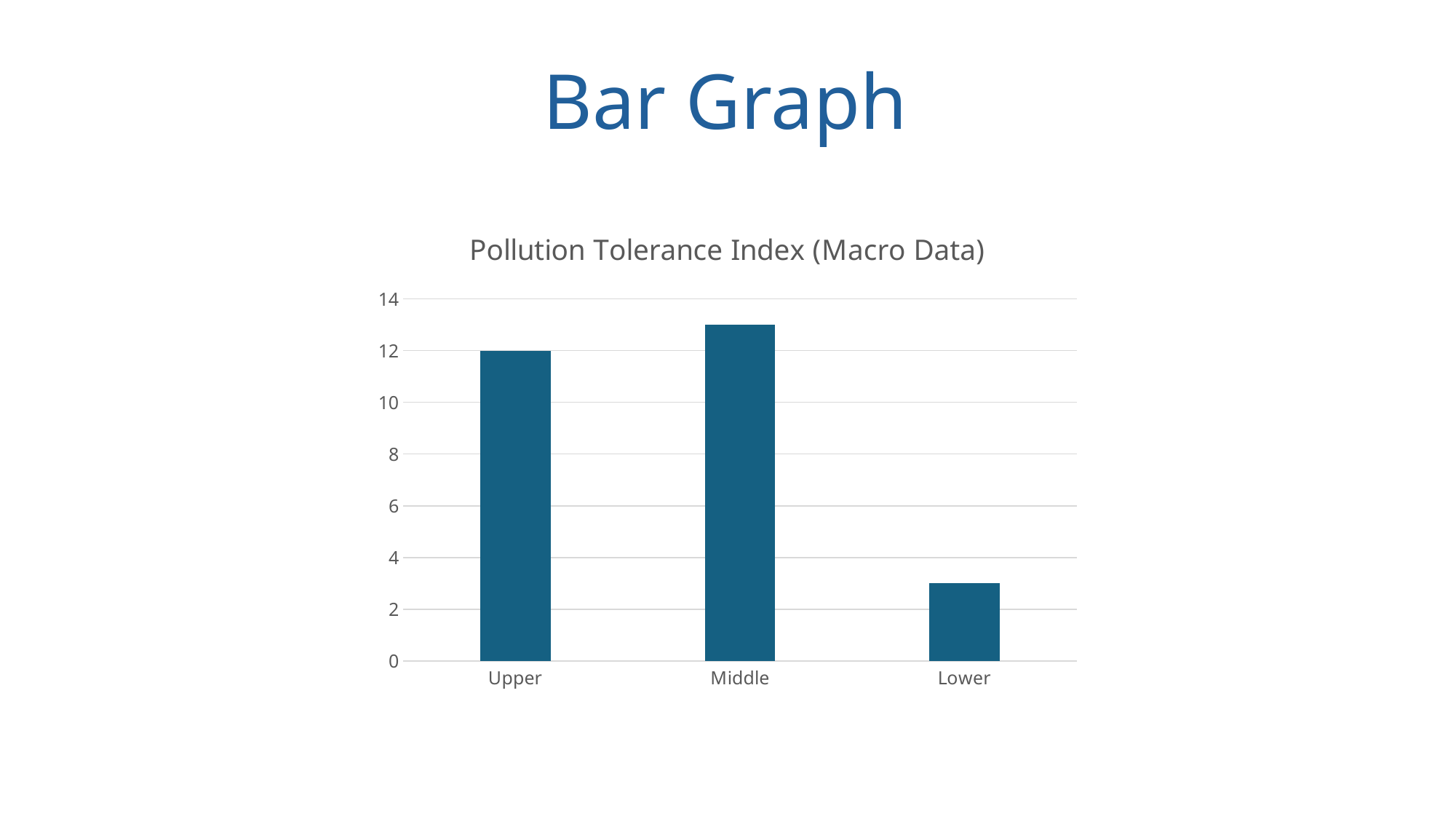
Is the value for Middle greater or less than 12? greater Which has a larger value, Upper or Lower? Upper Is the value for Middle greater or less than 14? less What is the title of the chart? Pollution Tolerance Index (Macro Data) Which category has the highest Pollution Tolerance Index value? Middle What is the Pollution Tolerance Index value for Upper? 12 Is the value for Lower greater or less than 4? less Which has a larger value, Upper or Middle? Middle What kind of chart is shown on the slide? bar chart Which category has the lowest Pollution Tolerance Index value? Lower How many categories are shown on the x axis? 3